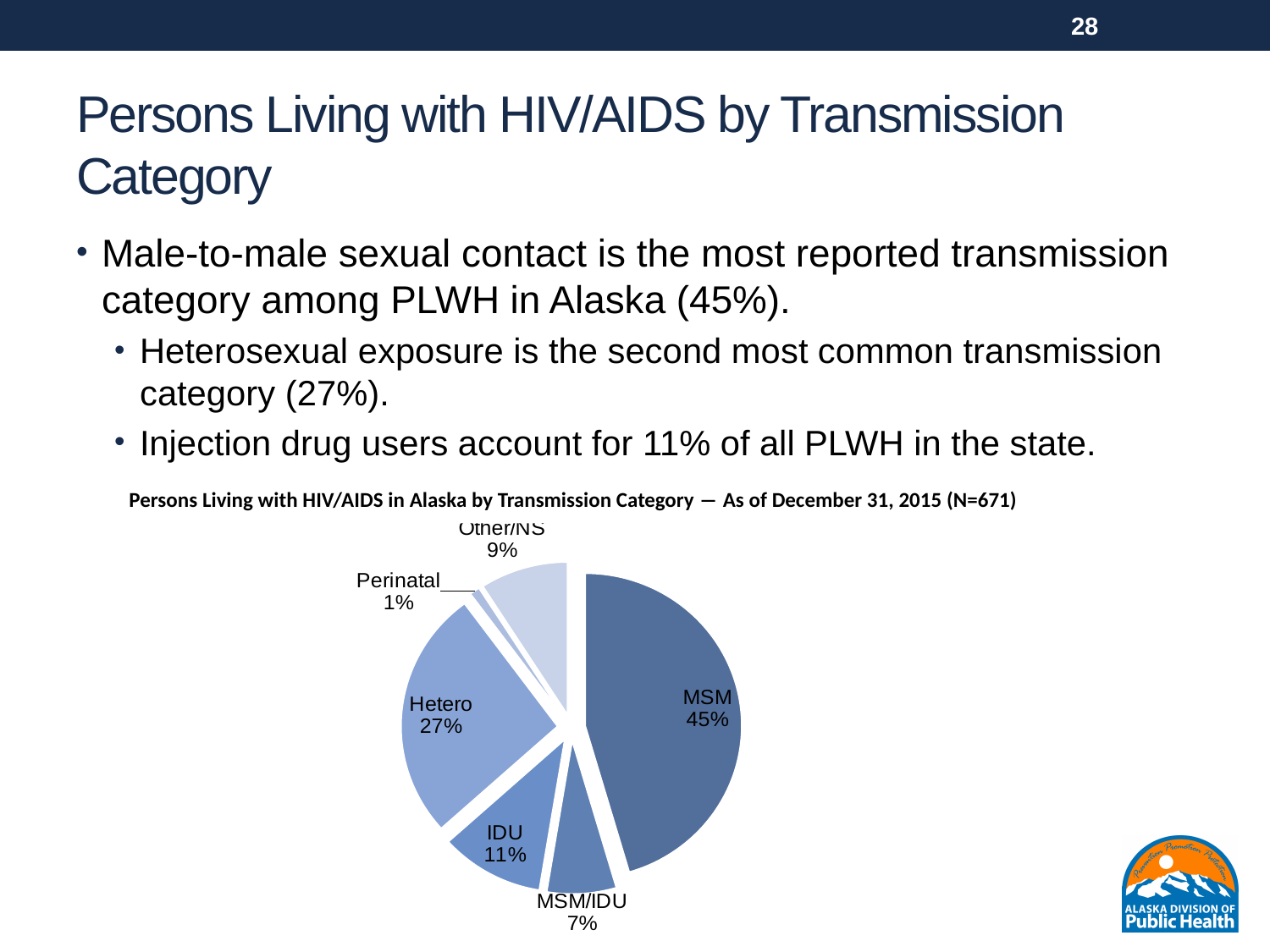
What is the value shown for Other/NS? 9% What is the value shown for MSM/IDU? 7% What kind of chart is shown on the slide? Pie chart What is the value shown for Hetero? 27% What is the N value given in the chart title? 671 What is the difference between the MSM and Hetero shares? 18% Which transmission category has the largest slice? MSM What share of the pie does MSM account for? 45% Which transmission category has the smallest slice? Perinatal How many transmission categories are shown in the pie chart? 6 Which is larger, the IDU slice or the Other/NS slice? IDU What is the value shown for IDU? 11%